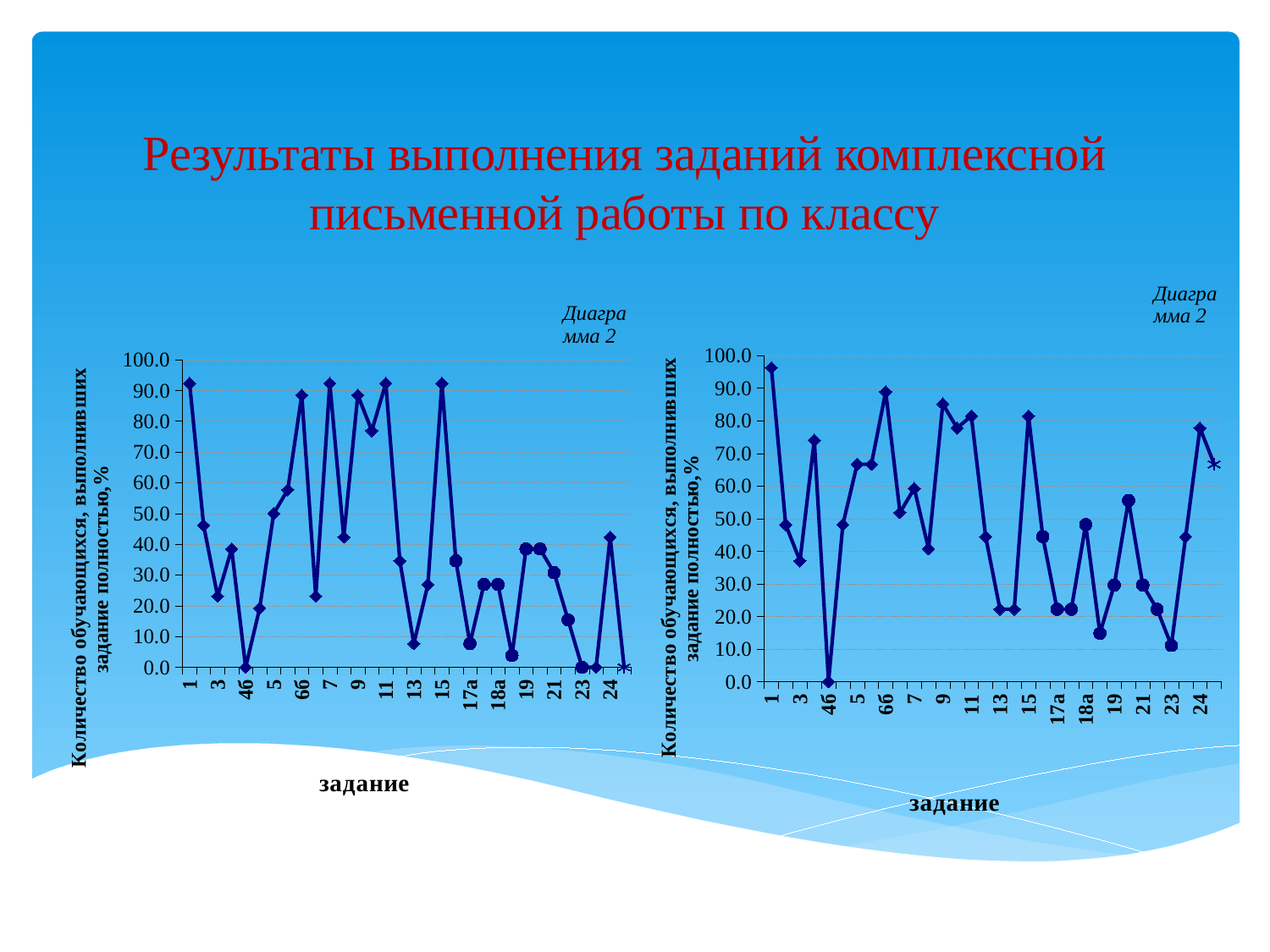
What type of chart is the left chart on the slide? line chart In the right chart, what is the value for task 4б? 0.0 In the right chart, is the value for task 3 greater or less than 40? less In the left chart, what is the value for task 4б? 0.0 In the left chart, which is larger, the value for task 1 or the value for task 3? task 1 In the right chart, which task (задание) has the lowest value? 4б In the right chart, which task (задание) has the highest value? 1 What is the x-axis title of the left chart? задание In the right chart, is the value for task 24 greater or less than 70? greater In the right chart, is the value for task 1 greater or less than 90? greater In the right chart, which is larger, the value for task 24 or the value for task 23? task 24